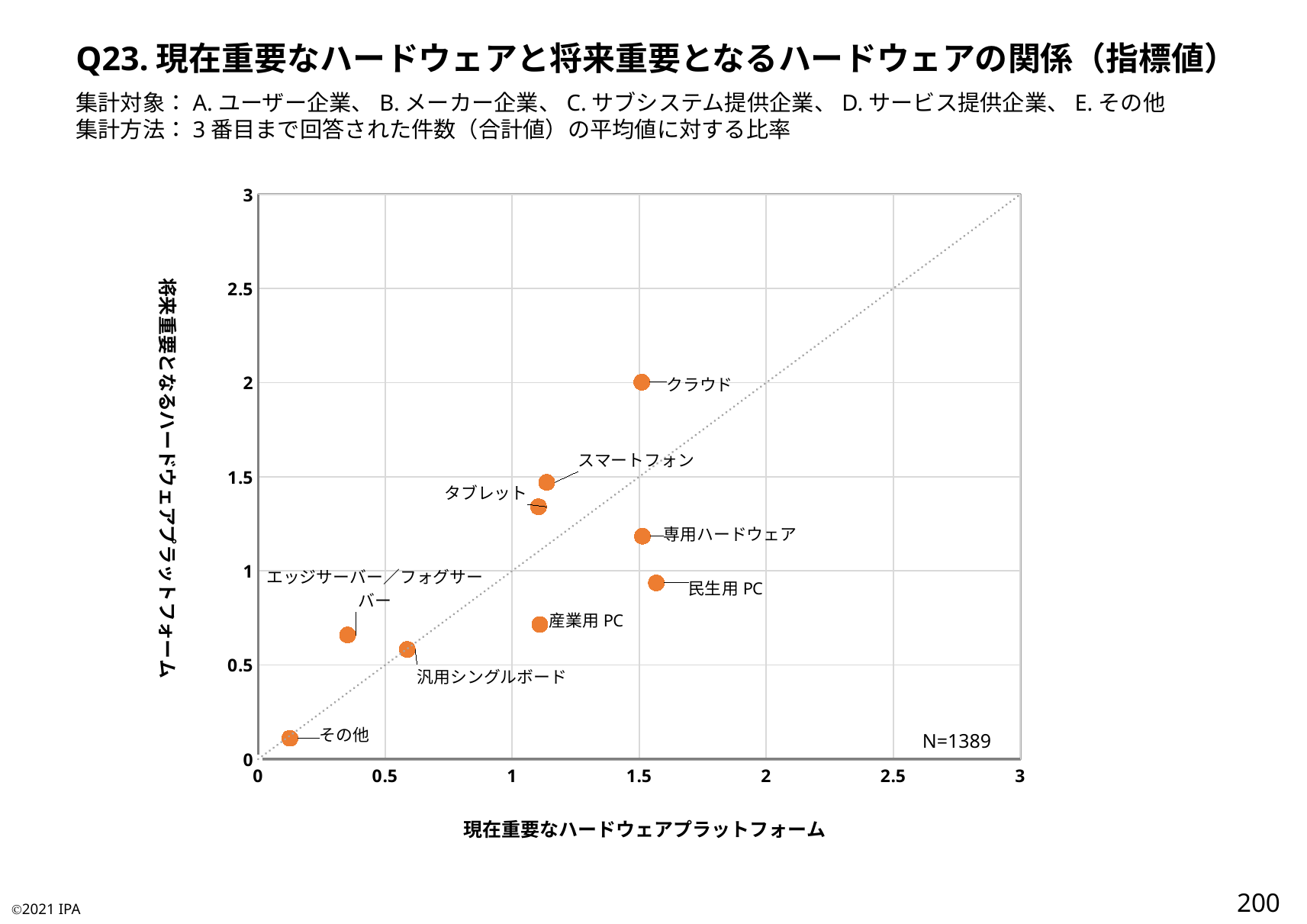
Which has the larger horizontal-axis value, 汎用シングルボード or 産業用 PC? 産業用 PC Is the vertical-axis value for クラウド greater or less than 1.5? greater Is the vertical-axis value for 民生用 PC greater or less than 1? less Is the horizontal-axis value for 産業用 PC greater or less than 1? greater What kind of chart is shown on the slide? scatter chart Which hardware platform has the highest value on the vertical axis (将来重要となるハードウェアプラットフォーム)? クラウド What is the sample size (N) shown on the chart? N=1389 Which hardware platform has the lowest value on the horizontal axis (現在重要なハードウェアプラットフォーム)? その他 What is the title of the horizontal axis? 現在重要なハードウェアプラットフォーム Which has the larger vertical-axis value, スマートフォン or 専用ハードウェア? スマートフォン How many data points are plotted in the chart? 9